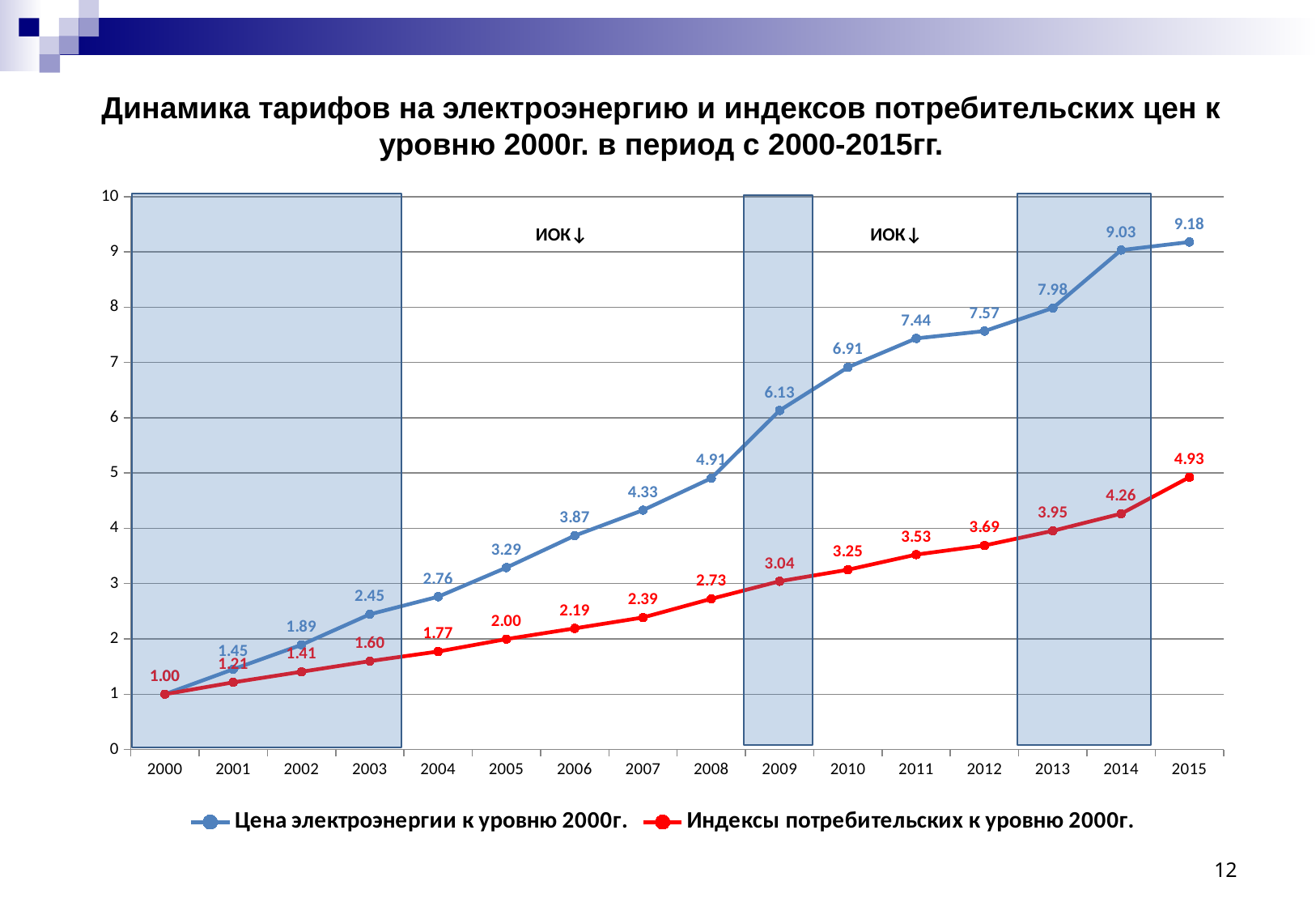
In which year does "Цена электроэнергии к уровню 2000г." reach its highest value? 2015 What is the difference between "Цена электроэнергии к уровню 2000г." and "Индексы потребительских к уровню 2000г." in 2015? 4.25 How many years are plotted along the x axis? 16 What is the value of "Цена электроэнергии к уровню 2000г." in 2014? 9.03 What is the value of "Индексы потребительских к уровню 2000г." in 2012? 3.69 What type of chart is shown on the slide? line chart Which series has the larger value in 2008: "Цена электроэнергии к уровню 2000г." or "Индексы потребительских к уровню 2000г."? Цена электроэнергии к уровню 2000г. What colour is the line for "Индексы потребительских к уровню 2000г."? red How many series does the legend list? 2 What is the value of "Цена электроэнергии к уровню 2000г." in 2009? 6.13 What is the lowest value of "Индексы потребительских к уровню 2000г." on the chart? 1.00 Do the values of "Цена электроэнергии к уровню 2000г." rise or fall from 2000 to 2015? rise